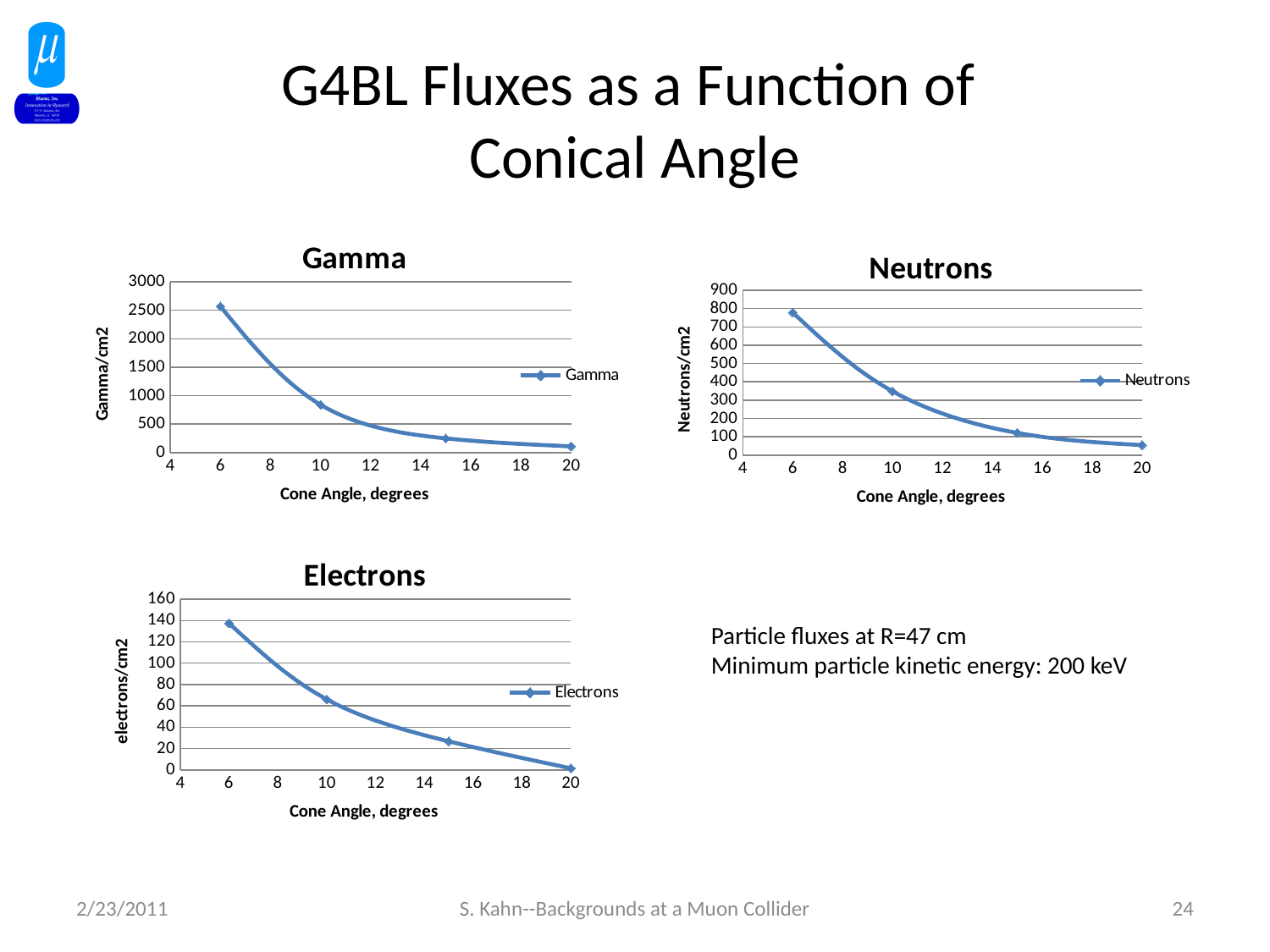
In the Gamma chart, which cone angle has the larger value, 10 degrees or 15 degrees? 10 In the Electrons chart, at which cone angle is the electron flux lowest? 20 In the Gamma chart, do the values rise or fall as the cone angle increases? fall What kind of chart is the Gamma chart? line chart What is the y-axis label of the Neutrons chart? Neutrons/cm2 In the Neutrons chart, is the value at a cone angle of 10 degrees greater or less than 400? less What is the x-axis label of the Electrons chart? Cone Angle, degrees In the Electrons chart, is the value at a cone angle of 6 degrees greater or less than 120? greater In the Neutrons chart, at which cone angle is the neutron flux highest? 6 How many data points are plotted in the Neutrons chart? 4 How many series does the legend of the Electrons chart list? 1